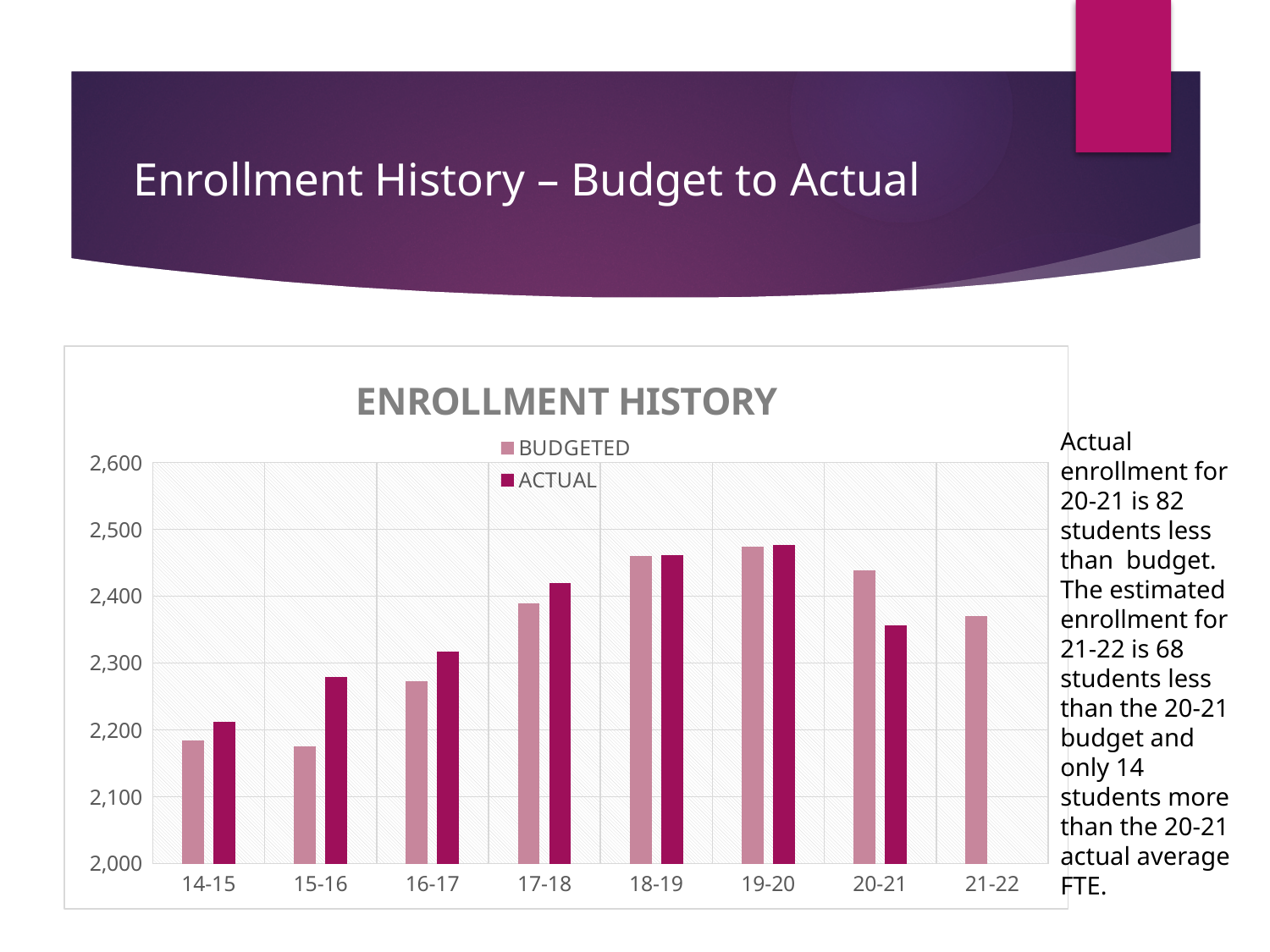
What kind of chart is shown on the slide? bar chart Is the BUDGETED value for 19-20 greater or less than 2,400? greater How many school years are shown on the x axis of the Enrollment History chart? 8 Is the ACTUAL value for 14-15 greater or less than 2,300? less Is the ACTUAL value for 20-21 greater or less than 2,400? less Do the ACTUAL values rise or fall from 14-15 to 19-20? rise How many series does the legend of the Enrollment History chart list? 2 What are the two legend entries of the Enrollment History chart? BUDGETED and ACTUAL For 20-21, which is larger, the BUDGETED or the ACTUAL value? BUDGETED For 15-16, which is larger, the BUDGETED or the ACTUAL value? ACTUAL Which school year has the lowest ACTUAL enrollment? 14-15